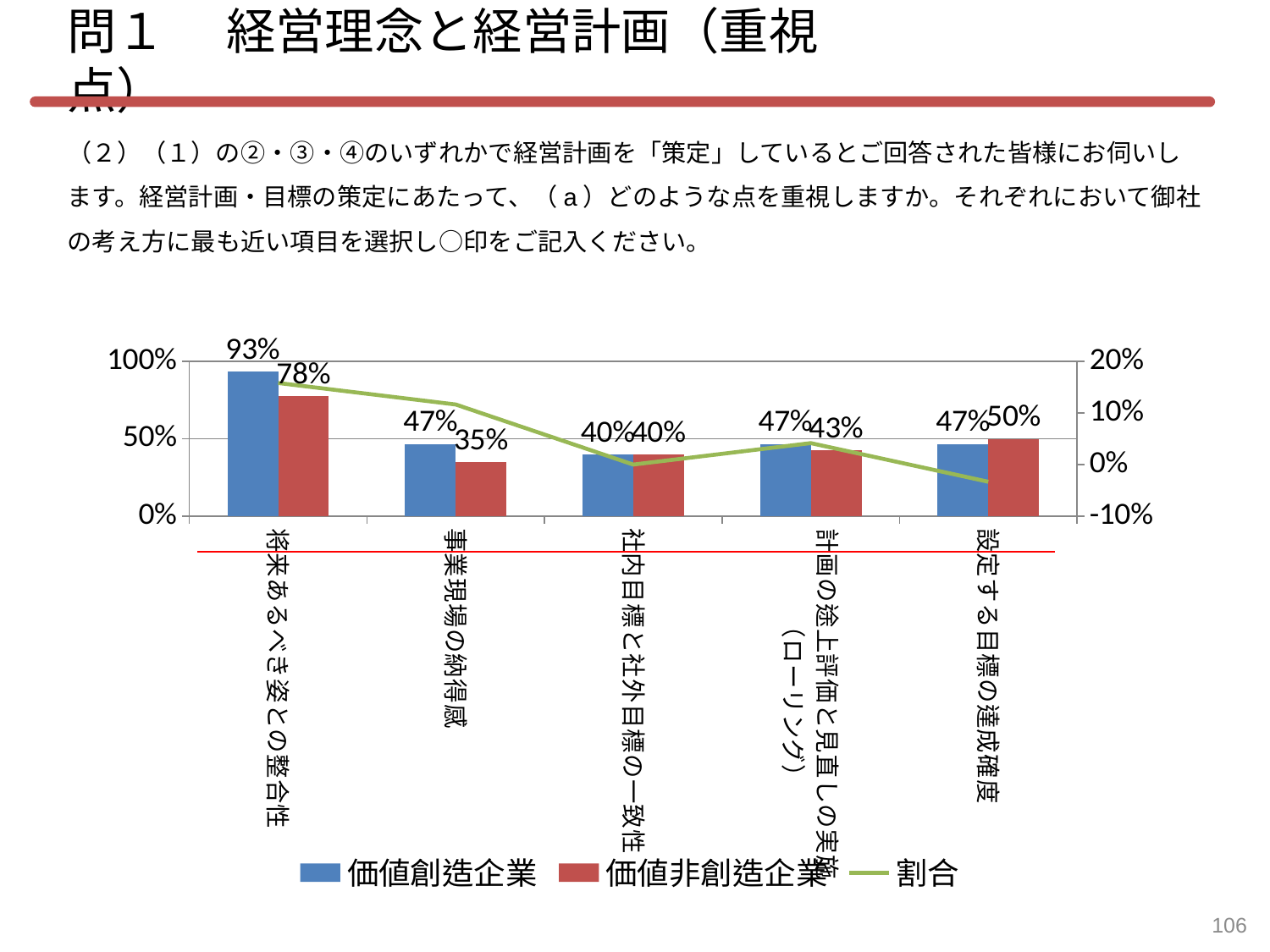
What is the value for 価値非創造企業 in the 設定する目標の達成確度 category? 50% Which category has the highest value for 価値創造企業? 将来あるべき姿との整合性 Is the 割合 line value for 将来あるべき姿との整合性 greater or less than 10%? greater How many series does the chart legend list? 3 What is the value for 価値創造企業 in the 将来あるべき姿との整合性 category? 93% Which series is drawn as a line rather than bars? 割合 What is the difference between 価値創造企業 and 価値非創造企業 in the 将来あるべき姿との整合性 category? 15% Is the 割合 line value for 設定する目標の達成確度 greater or less than 0%? less In the 設定する目標の達成確度 category, which series has the larger value, 価値創造企業 or 価値非創造企業? 価値非創造企業 How many categories are shown on the x axis of the chart? 5 Which category has the lowest value for 価値非創造企業? 事業現場の納得感 What is the value for 価値非創造企業 in the 事業現場の納得感 category? 35%